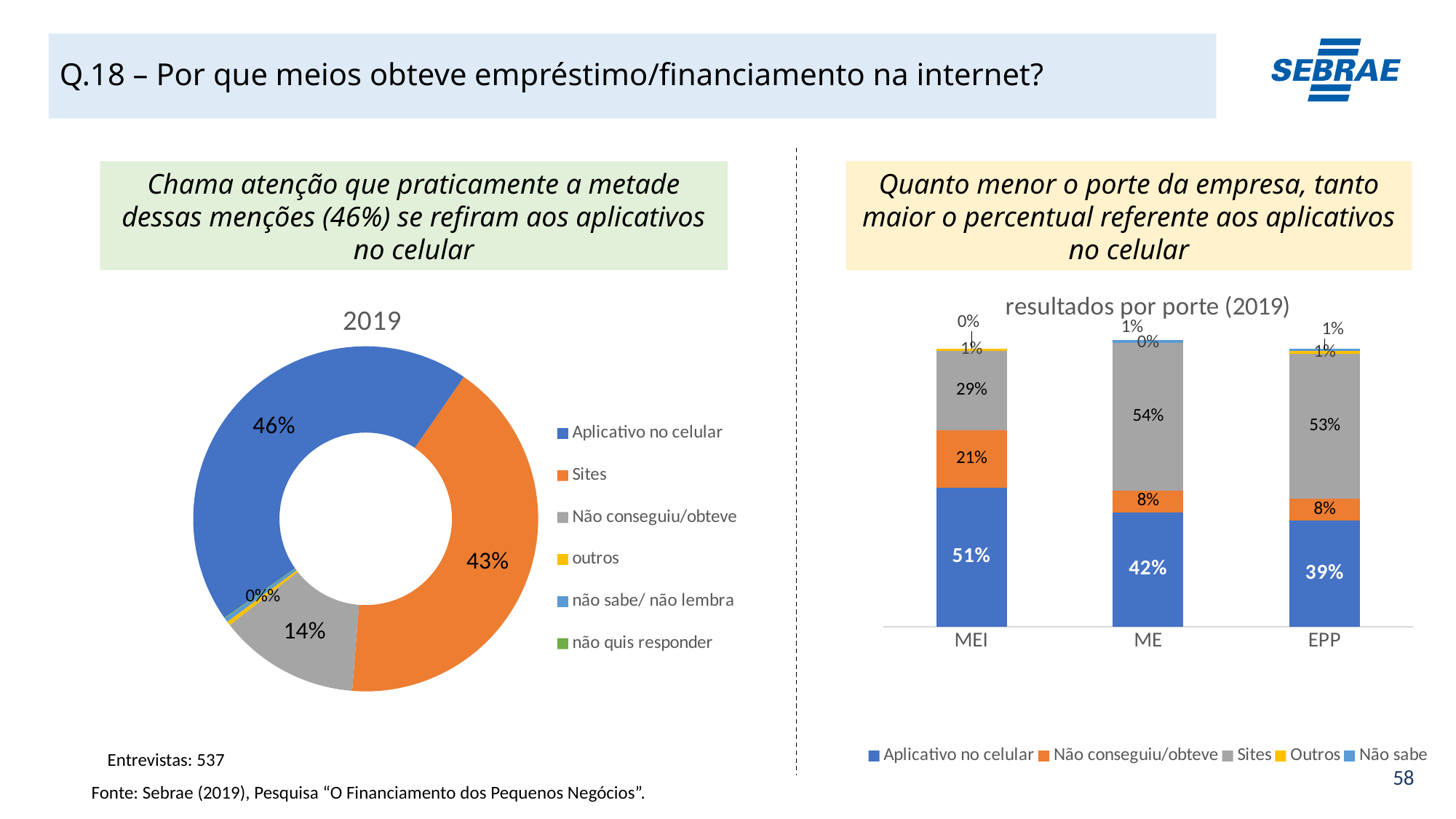
In the donut chart titled "2019", what is the difference in percentage points between Aplicativo no celular and Sites? 3 percentage points What kind of chart is the one titled "resultados por porte (2019)"? Stacked bar chart In the chart titled "resultados por porte (2019)", which company size has the lowest value for Aplicativo no celular? EPP In the donut chart titled "2019", what share is shown for Aplicativo no celular? 46% In the chart titled "resultados por porte (2019)", how many company sizes are shown on the x axis? 3 In the chart titled "resultados por porte (2019)", what is the value for Sites for ME? 54% In the donut chart titled "2019", what share is shown for Não conseguiu/obteve? 14% In the chart titled "resultados por porte (2019)", what is the value for Aplicativo no celular for MEI? 51% In the donut chart titled "2019", what share is shown for Sites? 43% In the donut chart titled "2019", how many entries does the legend list? 6 In the donut chart titled "2019", which category has the largest share? Aplicativo no celular In the chart titled "resultados por porte (2019)", what is the value for Não conseguiu/obteve for EPP? 8%